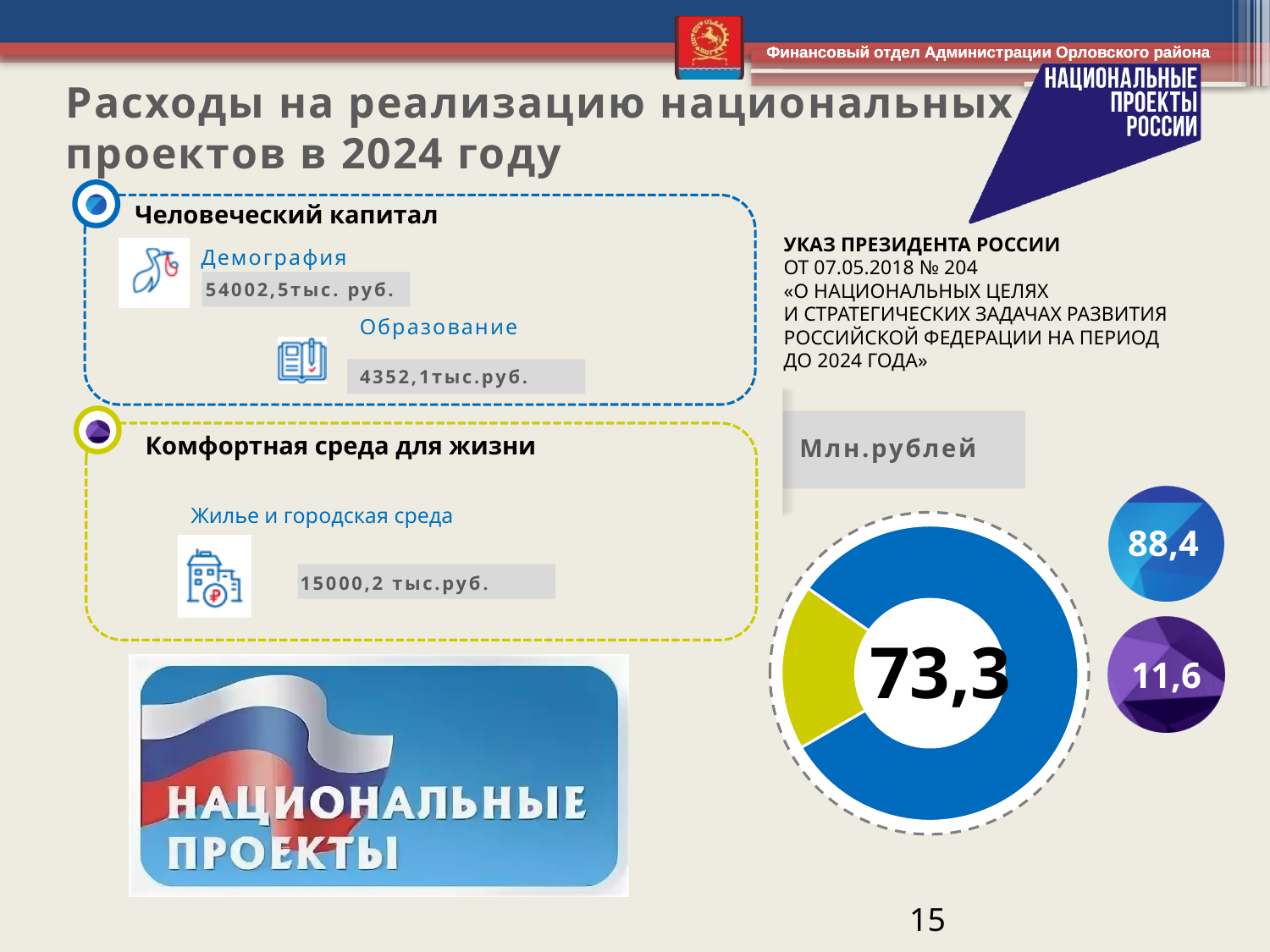
Which slice of the donut chart is the smallest? the yellow slice Which slice of the donut chart is larger, the blue one or the yellow one? blue How many slices does the donut chart on the right have? 2 What unit label is shown in the grey box above the donut chart? Млн.рублей What kind of chart is shown on the right side of the slide? pie chart (donut) What value is shown in the blue circle to the right of the donut chart? 88,4 What value is shown in the purple circle to the right of the donut chart? 11,6 Does the donut chart on the right have a legend? No What number is printed in the centre of the donut chart? 73,3 Which of the two values beside the donut chart is larger, 88,4 or 11,6? 88,4